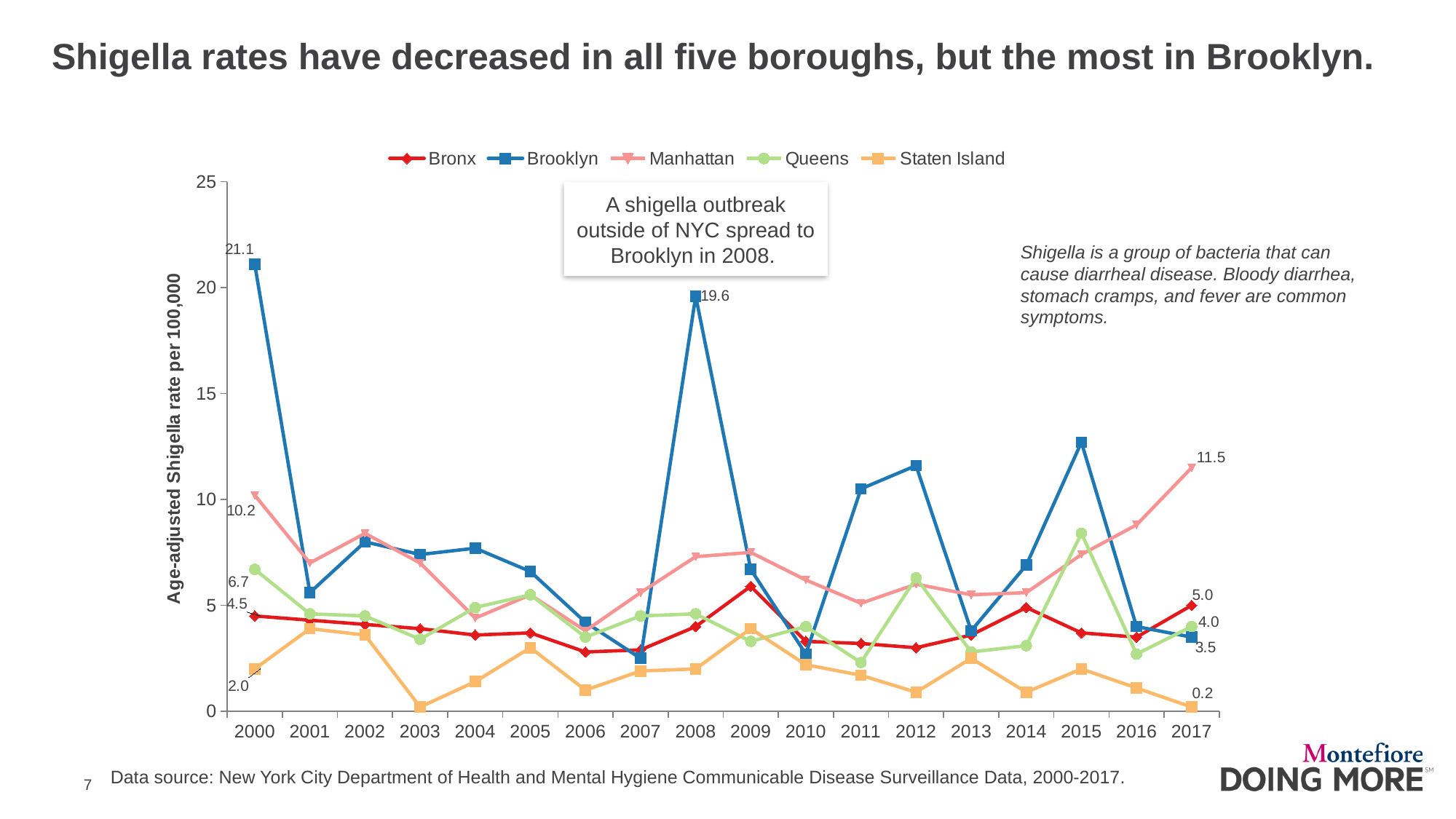
Which borough had the highest Shigella rate in 2000? Brooklyn What kind of chart is shown on the slide? Line chart What was the age-adjusted Shigella rate for Brooklyn in 2000? 21.1 By how much did the Brooklyn Shigella rate fall between 2000 (21.1) and 2017 (3.5)? 17.6 What was the Manhattan Shigella rate in 2017? 11.5 What was the Brooklyn Shigella rate in 2008? 19.6 What was the Staten Island Shigella rate in 2017? 0.2 How many boroughs (series) does the legend list? 5 What is the label of the y axis? Age-adjusted Shigella rate per 100,000 In 2017, which had the higher Shigella rate, Manhattan or the Bronx? Manhattan How many years are plotted along the x axis? 18 Is the Brooklyn Shigella rate in 2015 greater or less than 10? greater